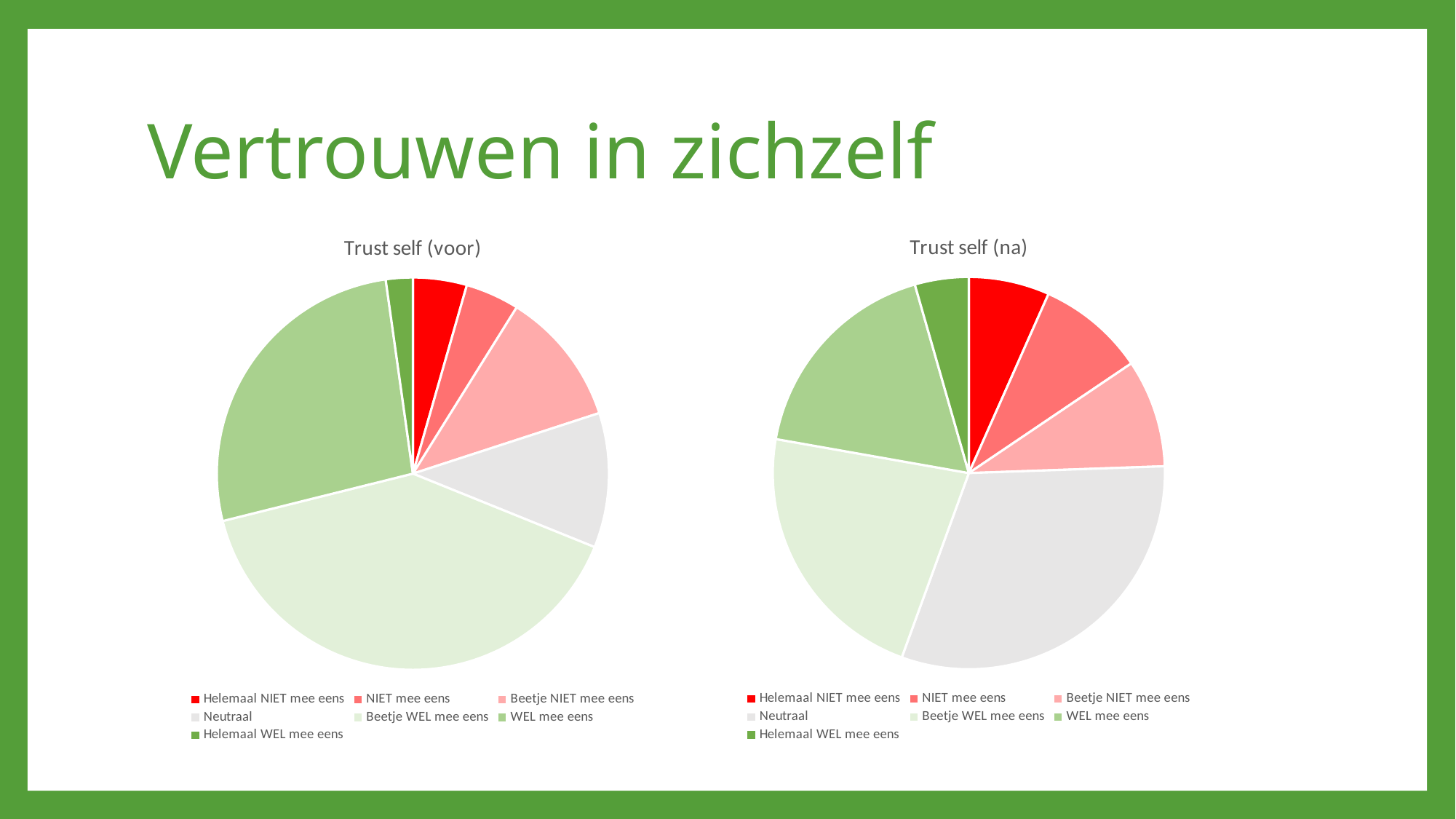
In the "Trust self (voor)" chart, which slice is larger: "Beetje NIET mee eens" or "Helemaal NIET mee eens"? Beetje NIET mee eens Which colour represents "Helemaal NIET mee eens" in the "Trust self (voor)" chart? red How many entries does the legend of the "Trust self (na)" chart list? 7 What kind of chart is "Trust self (voor)"? pie chart What is the title of the pie chart on the right side of the slide? Trust self (na) In the "Trust self (na)" chart, which slice is larger: "Neutraal" or "WEL mee eens"? Neutraal In the "Trust self (voor)" chart, which category has the smallest slice? Helemaal WEL mee eens What kind of chart is "Trust self (na)"? pie chart In the "Trust self (voor)" chart, which category has the largest slice? Beetje WEL mee eens In the "Trust self (na)" chart, which category has the largest slice? Neutraal In the "Trust self (voor)" chart, which slice is larger: "WEL mee eens" or "Neutraal"? WEL mee eens How many categories does the "Trust self (voor)" pie chart have? 7